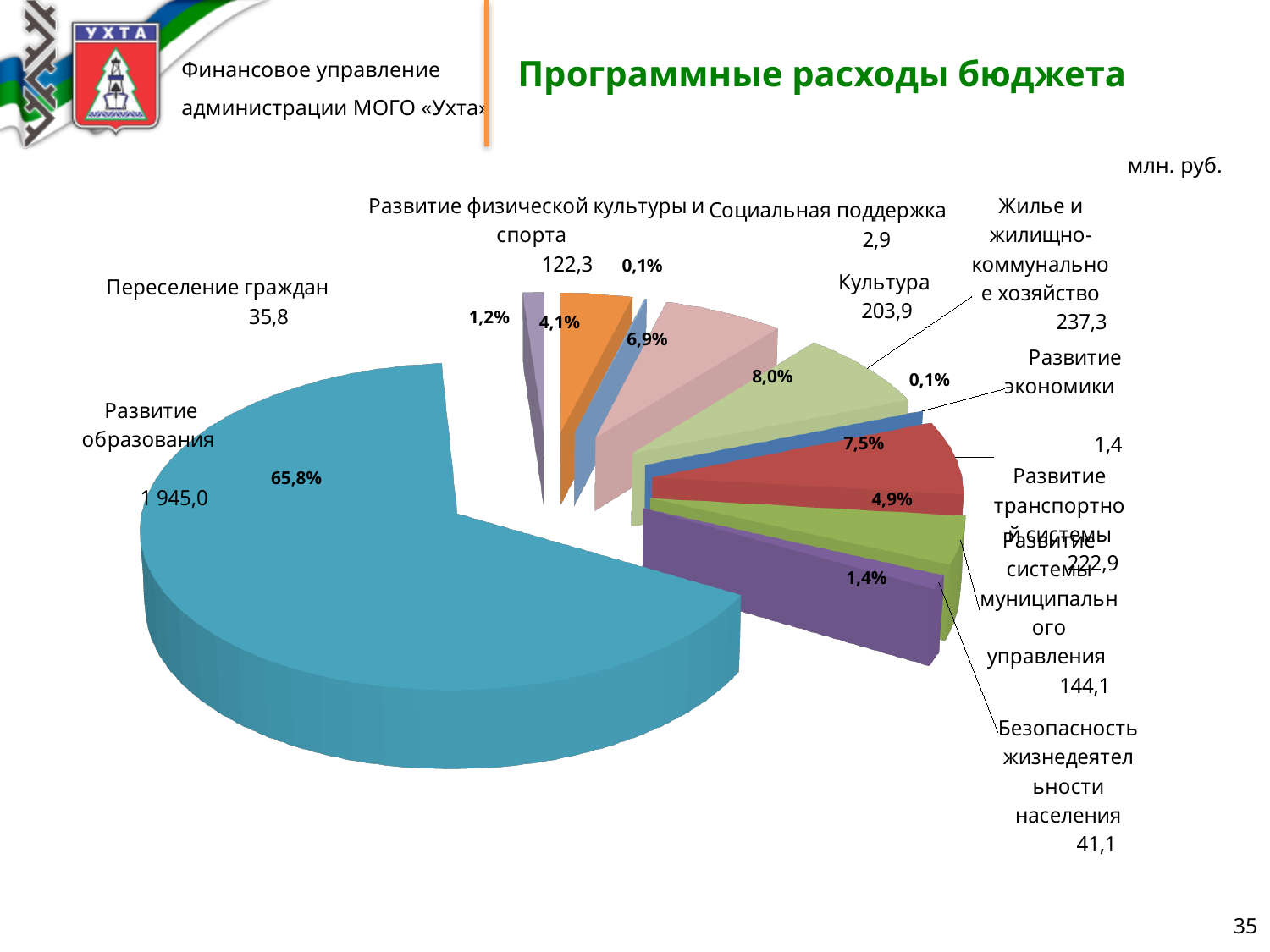
Which is larger, Развитие транспортной системы or Культура? Развитие транспортной системы What is the value for Культура? 203,9 What type of chart is shown on the slide? pie chart How many categories are shown in the pie chart? 10 What is the difference between Жилье и жилищно-коммунальное хозяйство and Развитие транспортной системы? 14,4 What share of the pie does Развитие образования represent? 65,8% What is the value for Жилье и жилищно-коммунальное хозяйство? 237,3 What is the title of the chart? Программные расходы бюджета What is the value for Развитие образования? 1 945,0 What is the value for Безопасность жизнедеятельности населения? 41,1 Which category has the largest value? Развитие образования Which category has the smallest value? Развитие экономики